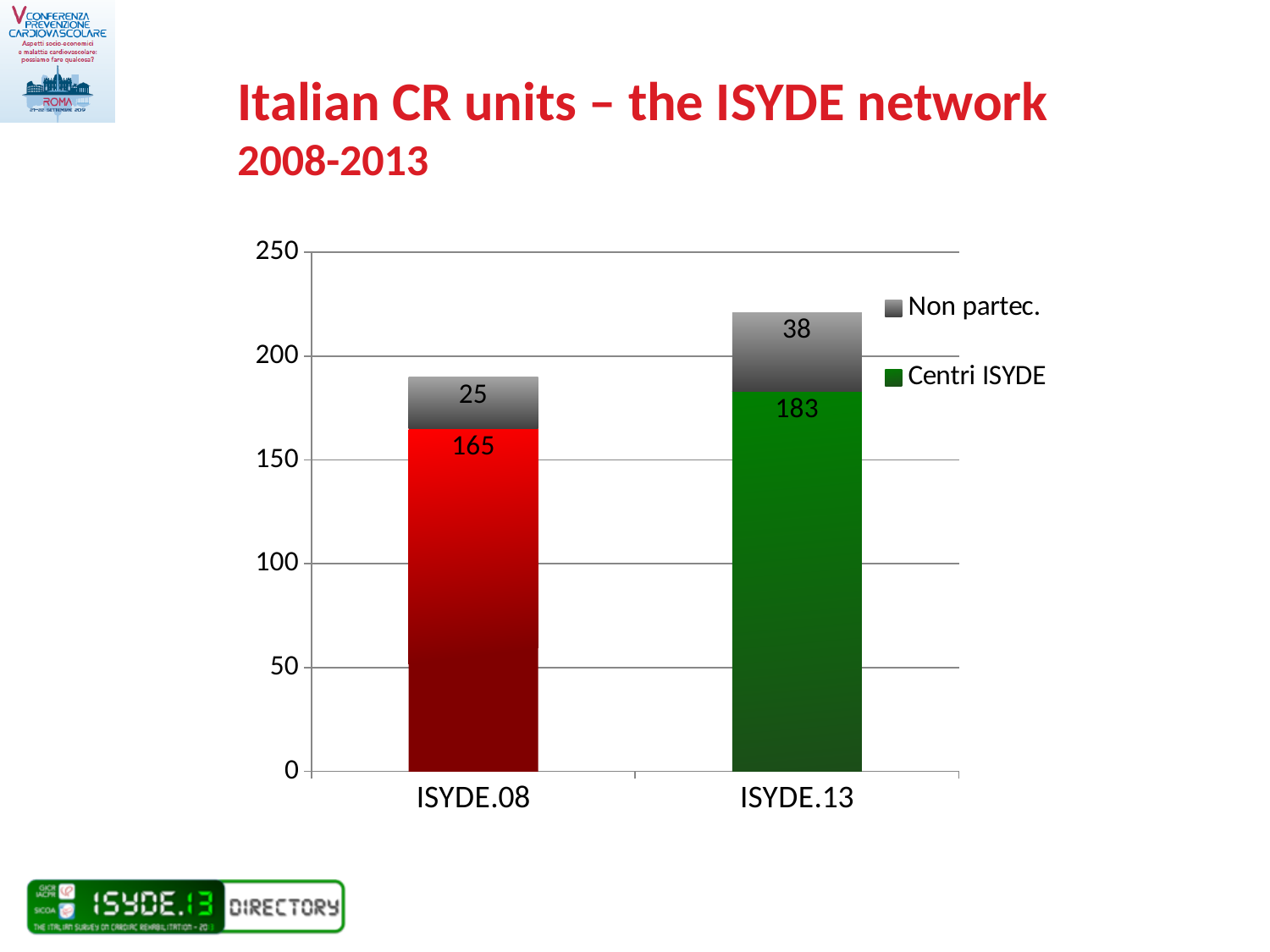
What is the value of Centri ISYDE for ISYDE.13? 183 What is the value of Non partec. for ISYDE.08? 25 How many categories are shown on the x axis? 2 How many series does the legend list? 2 What kind of chart is shown on the slide? stacked bar chart What is the value of Centri ISYDE for ISYDE.08? 165 Which category has the higher Non partec. value, ISYDE.08 or ISYDE.13? ISYDE.13 What is the value of Non partec. for ISYDE.13? 38 What is the total of the stacked bar for ISYDE.13? 221 What is the difference between the Centri ISYDE values for ISYDE.13 and ISYDE.08? 18 What is the total of the stacked bar for ISYDE.08? 190 Is the total for ISYDE.13 greater or less than 200? greater